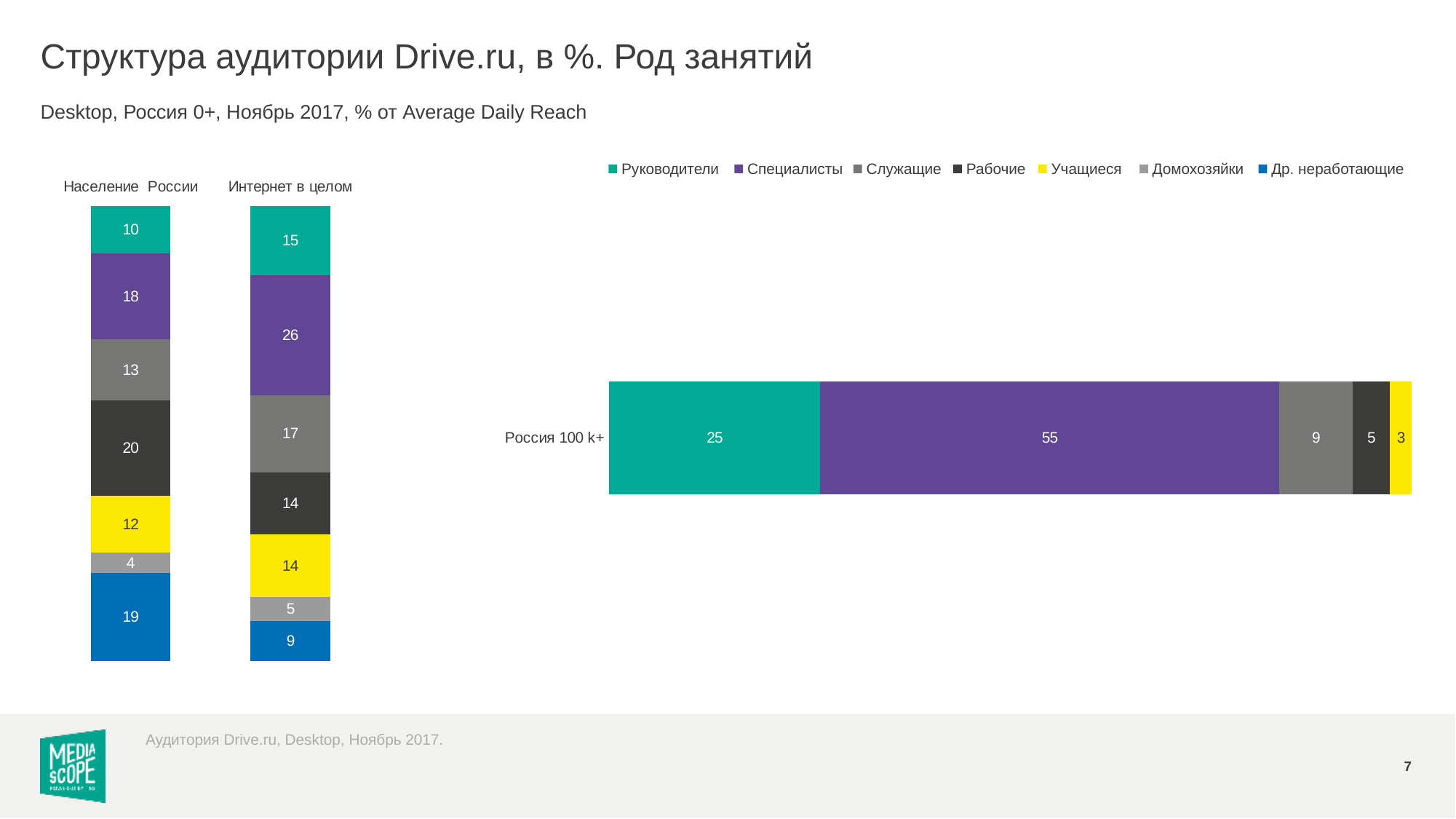
In the right chart (Россия 100 k+), what is the total of the labelled segments? 97 In the left chart, which is larger: Др. неработающие in Население России or Др. неработающие in Интернет в целом? Население России In the right chart (Россия 100 k+), which occupation group has the largest share? Специалисты In the right chart (Россия 100 k+), what is the value for Руководители? 25 What kind of chart is the right chart (Россия 100 k+)? Stacked bar chart How many series does the legend list? 7 How many bars are shown in the left chart? 2 In the left chart, what is the value for Специалисты in the Интернет в целом bar? 26 In the left chart, what is the difference between Специалисты in Интернет в целом and Специалисты in Население России? 8 In the left chart, which occupation group has the smallest value in the Население России bar? Домохозяйки Which colour represents Учащиеся in the legend? Yellow In the left chart, what is the value for Рабочие in the Население России bar? 20